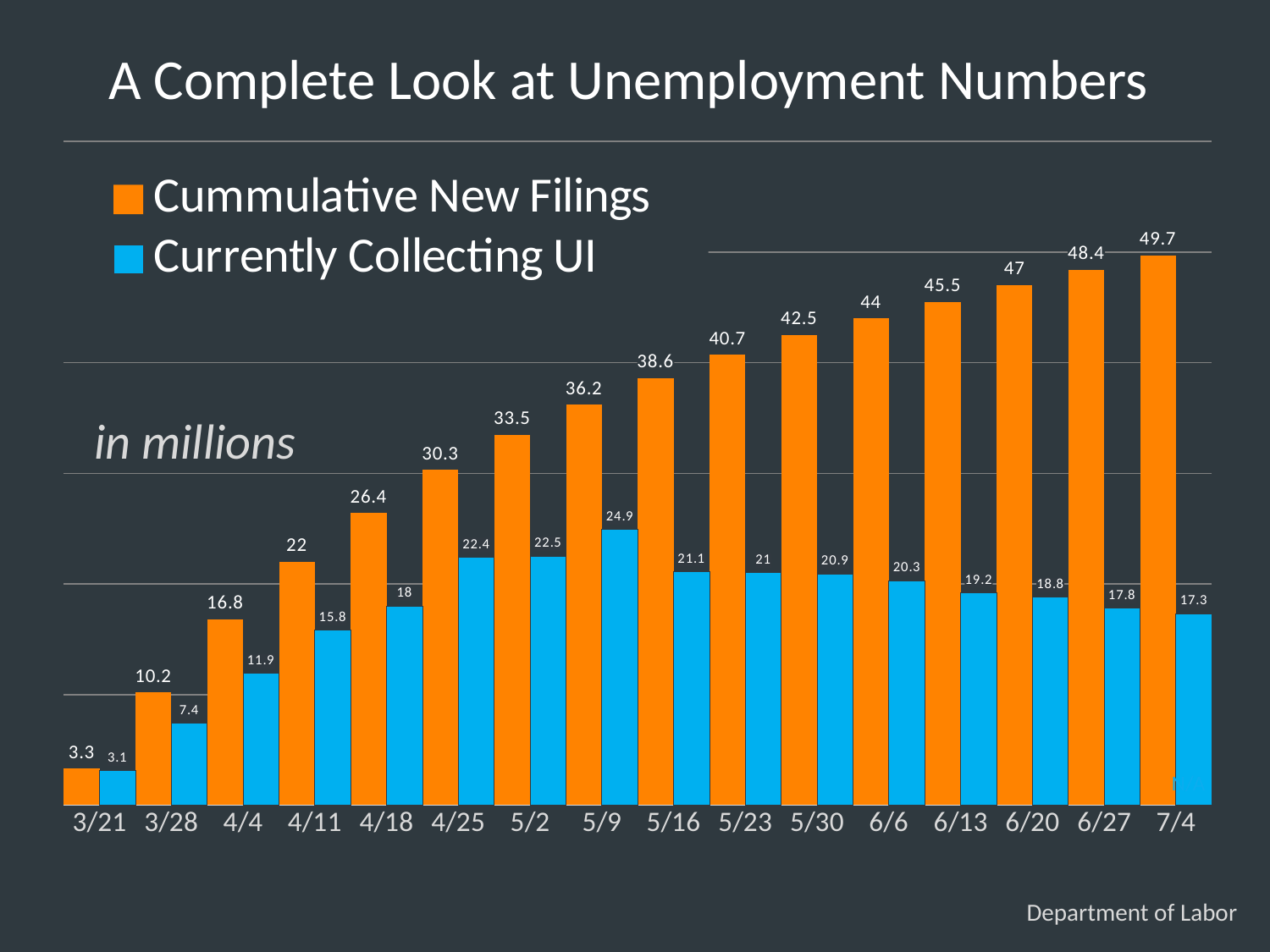
What is the difference between Cummulative New Filings and Currently Collecting UI on 7/4? 32.4 What is the value of Cummulative New Filings for 7/4? 49.7 How many series does the legend list? 2 What is the value of Currently Collecting UI for 5/9? 24.9 How many dates are shown on the x axis? 16 Which date has the lowest value for Cummulative New Filings? 3/21 Which date has the highest value for Currently Collecting UI? 5/9 Do the Cummulative New Filings values rise or fall from 3/21 to 7/4? Rise What is the value of Currently Collecting UI for 4/11? 15.8 What is the value of Cummulative New Filings for 5/23? 40.7 What kind of chart is shown on the slide? Bar chart Which is larger on 4/25: Cummulative New Filings or Currently Collecting UI? Cummulative New Filings